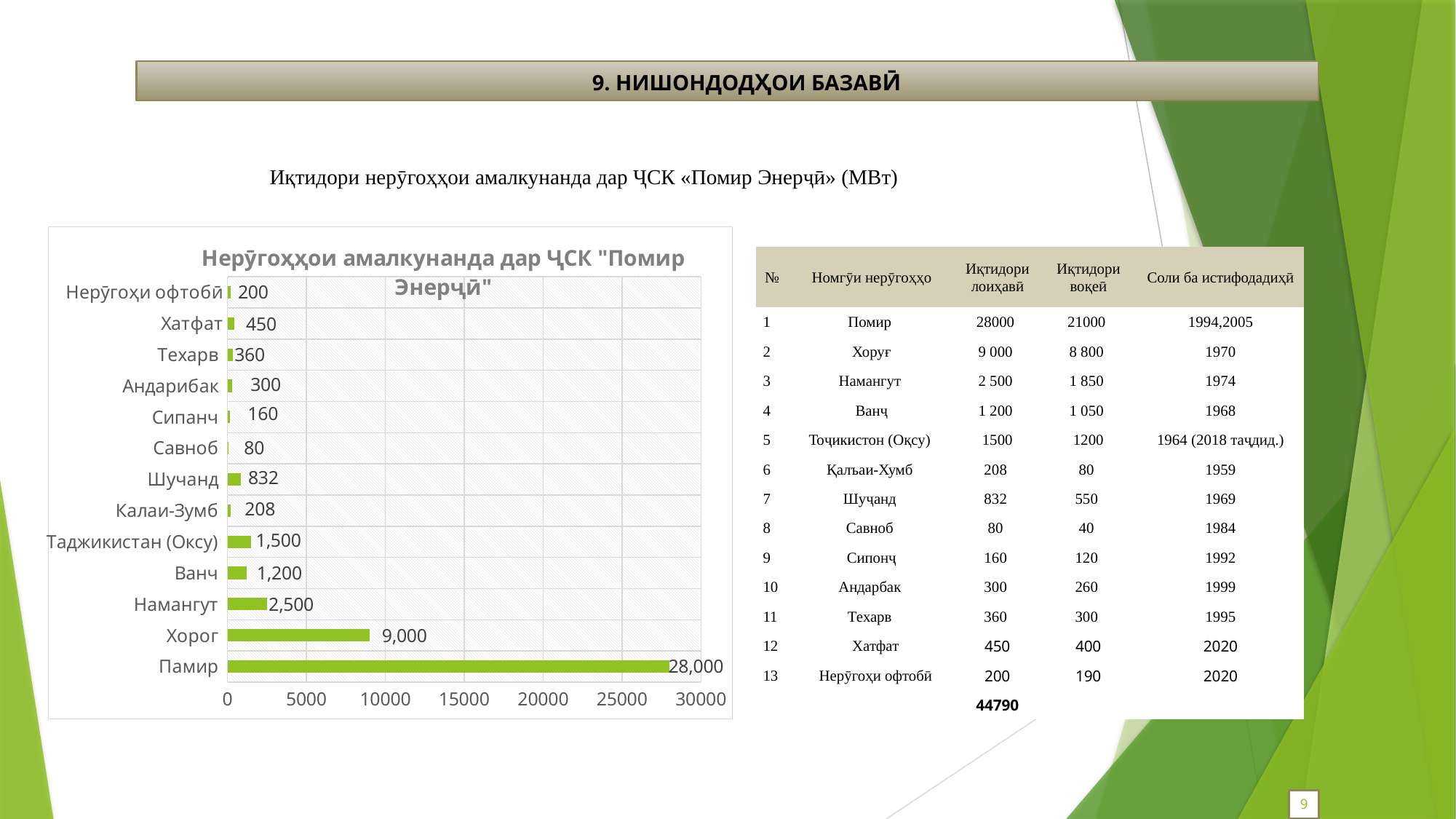
What is the value for Шучанд in the chart? 832 What is the title of the chart? Нерӯгоҳҳои амалкунанда дар ҶСК "Помир Энерҷӣ" Which is larger, the value for Намангут or the value for Таджикистан (Оксу)? Намангут What is the value for Савноб in the chart? 80 How many categories are shown in the chart? 13 Is the value for Хорог greater or less than 10000? less What is the value for Памир in the chart? 28,000 Which category has the highest value in the chart? Памир Which category has the lowest value in the chart? Савноб What is the difference between the values for Памир and Хорог? 19,000 What is the value for Хорог in the chart? 9,000 What type of chart is shown on the slide? bar chart